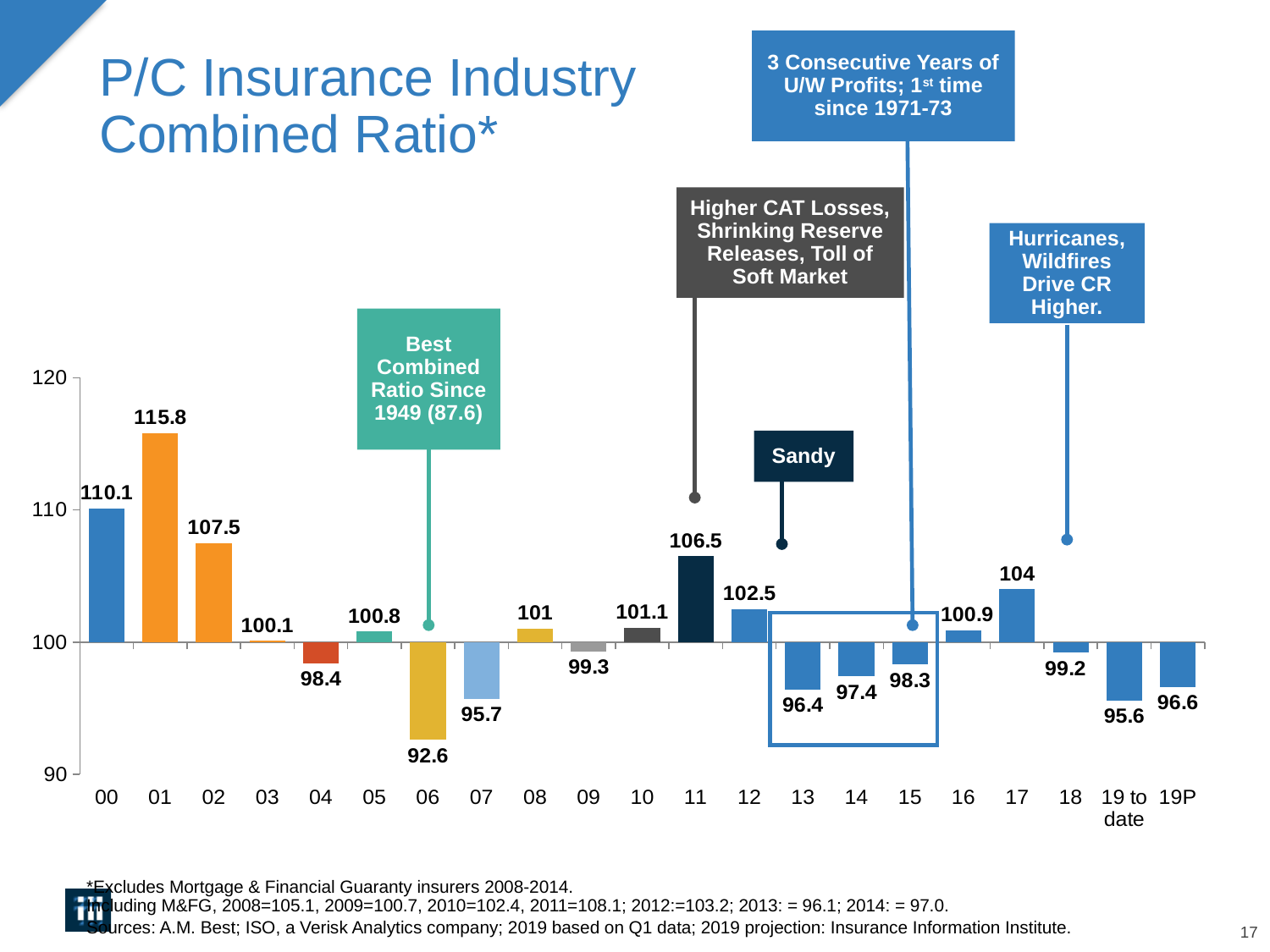
Is the combined ratio for 2017 (17) greater or less than 100? greater What type of chart is shown on the slide? Bar chart What is the difference between the combined ratio for 2000 (00) and 2002 (02)? 2.6 What is the combined ratio shown for 19P? 96.6 How many bars (year categories) are plotted on the chart? 21 What is the combined ratio shown for 2006 (06)? 92.6 What is the title of the chart on the slide? P/C Insurance Industry Combined Ratio* What is the combined ratio shown for 2001 (01)? 115.8 Which is larger, the combined ratio for 2013 (13) or for 2015 (15)? 15 Which year has the highest combined ratio on the chart? 01 What is the combined ratio shown for 2011 (11)? 106.5 Which year has the lowest combined ratio on the chart? 06